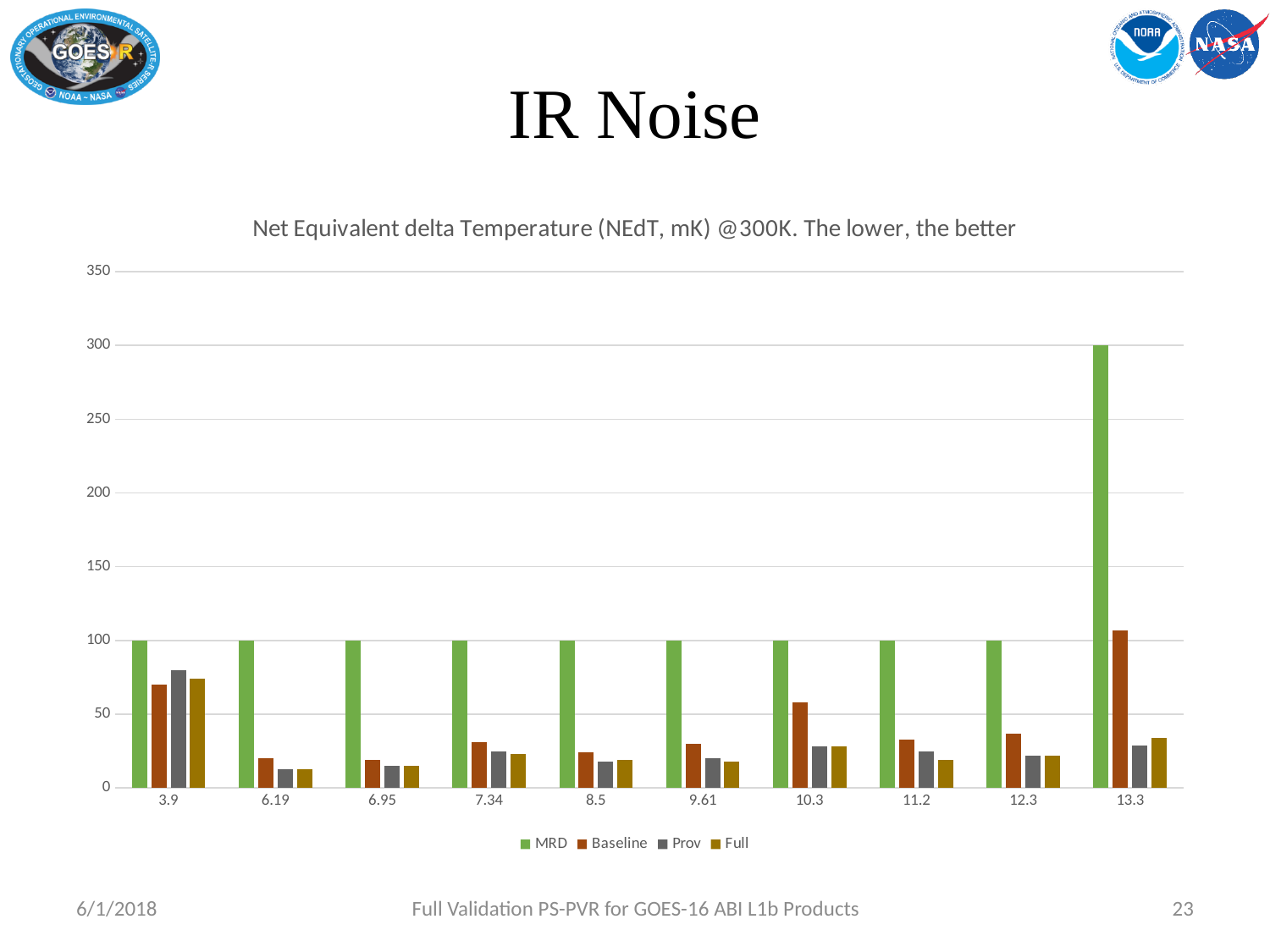
Is the Baseline value for the 3.9 category greater or less than 50? greater How many series does the chart's legend list? 4 Which is larger, the Baseline value for 10.3 or the Baseline value for 11.2? 10.3 What is the title of the chart? Net Equivalent delta Temperature (NEdT, mK) @300K. The lower, the better Which category has the highest MRD value? 13.3 Is the Baseline value for the 6.19 category greater or less than 50? less What is the MRD value for the 8.5 category? 100 What kind of chart is shown on the slide? bar chart What is the MRD value for the 13.3 category? 300 Which series is shown in green in the legend? MRD How many categories are shown along the x axis of the chart? 10 Is the Prov value for the 3.9 category greater or less than 50? greater